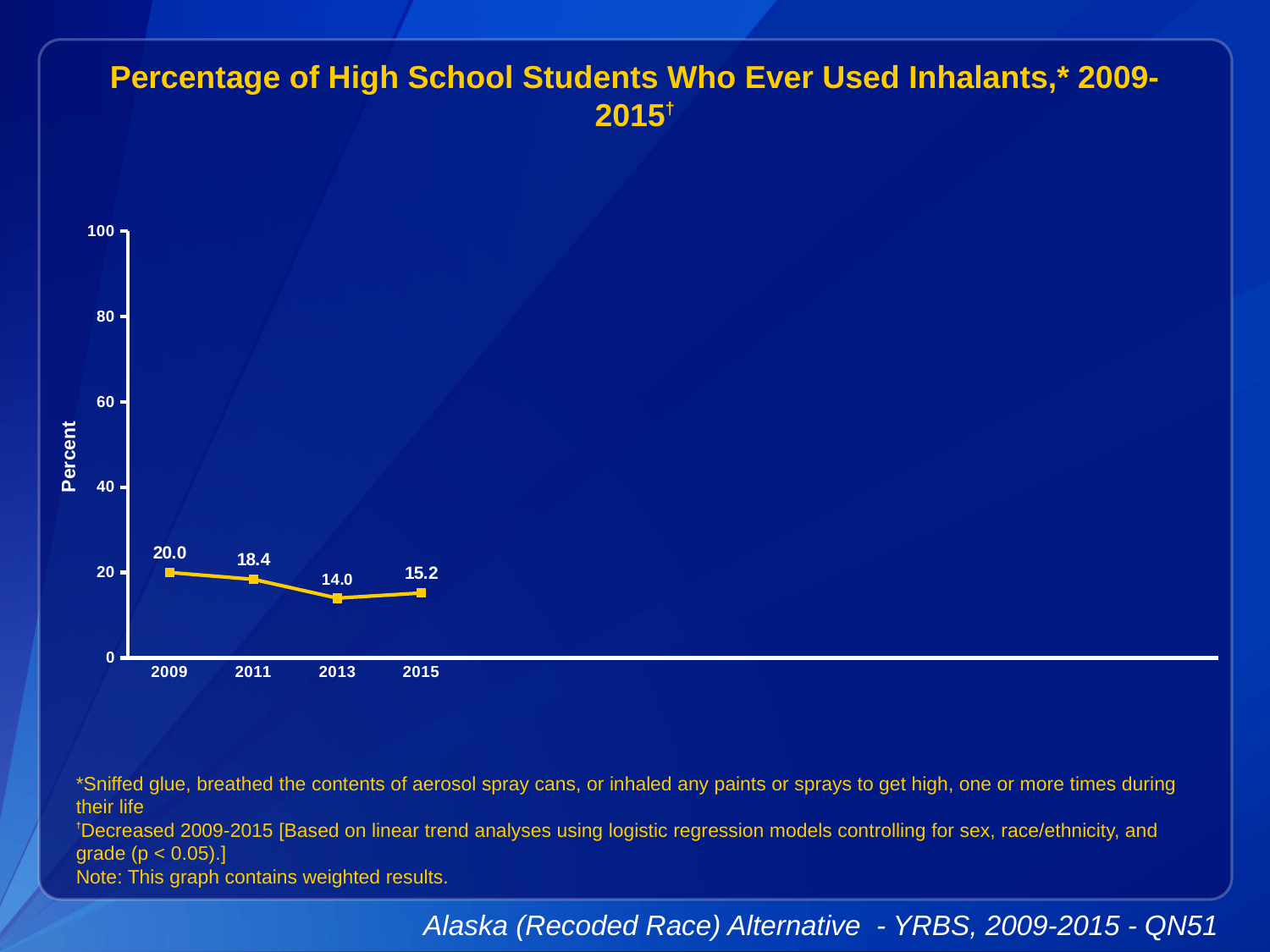
What kind of chart is shown on the slide? line chart Is the value for 2011 greater or less than 20? less What is the label on the vertical axis of the chart? Percent Which year has a larger value, 2011 or 2015? 2011 What is the value plotted for 2013? 14.0 Which year has the highest percentage of students who ever used inhalants? 2009 Which year has the lowest percentage of students who ever used inhalants? 2013 How many years are plotted on the chart? 4 What percentage of high school students had ever used inhalants in 2009? 20.0 What is the difference between the 2009 value and the 2015 value? 4.8 Do the values generally rise or fall from 2009 to 2015? fall What is the value plotted for 2015? 15.2